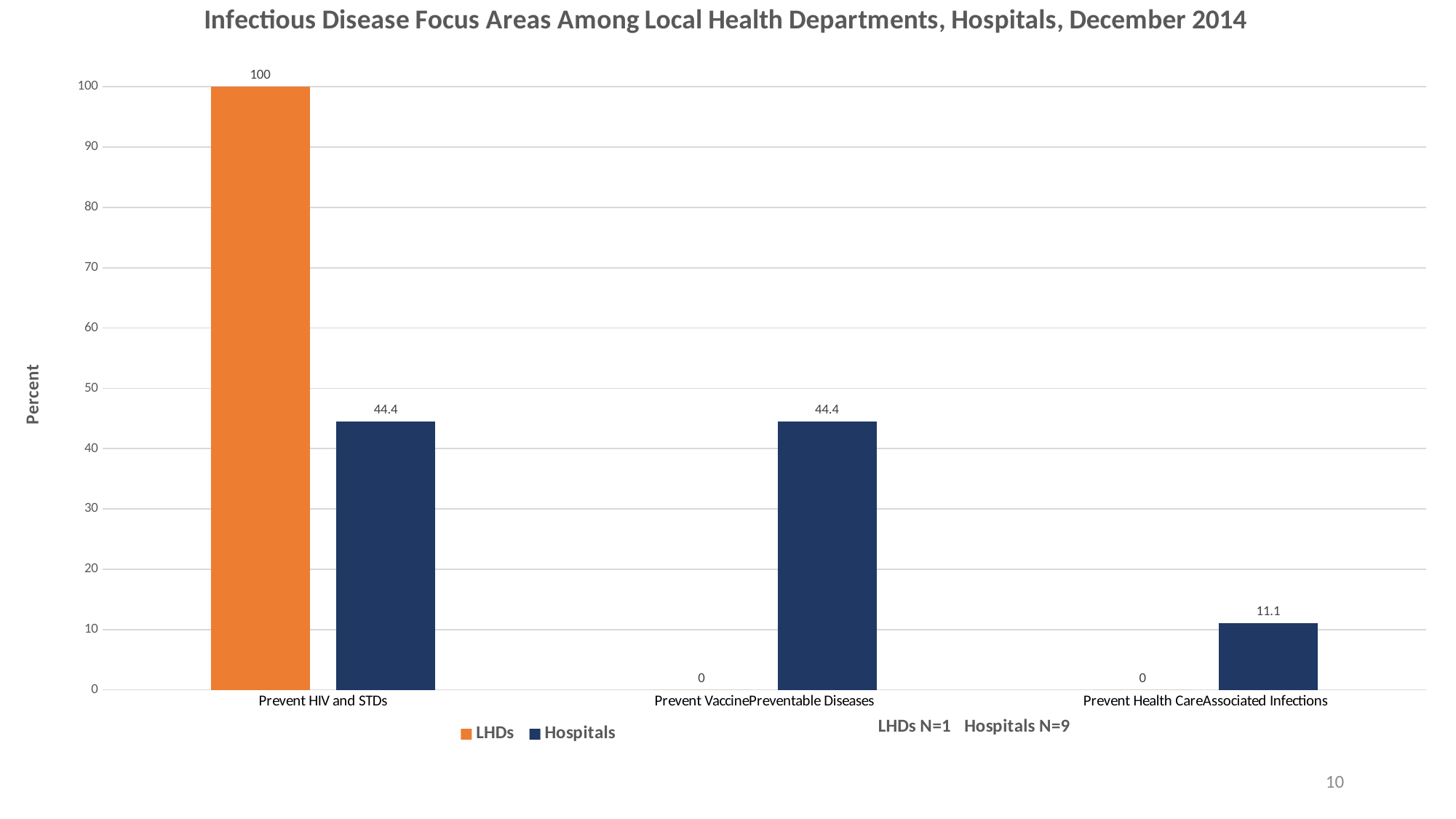
How many series does the legend list? 2 What is the LHDs value for Prevent Health Care-Associated Infections? 0 For Prevent HIV and STDs, which series has the larger value, LHDs or Hospitals? LHDs What is the difference between the LHDs and Hospitals values for Prevent HIV and STDs? 55.6 What kind of chart is shown on the slide? Bar chart Which category has the highest Hospitals value? Prevent HIV and STDs and Prevent Vaccine-Preventable Diseases (tied at 44.4) How many categories are shown on the x axis? 3 What is the Hospitals value for Prevent Vaccine-Preventable Diseases? 44.4 What is the LHDs value for Prevent HIV and STDs? 100 What is the label on the vertical axis? Percent What is the Hospitals value for Prevent Health Care-Associated Infections? 11.1 Which category has the lowest Hospitals value? Prevent Health Care-Associated Infections